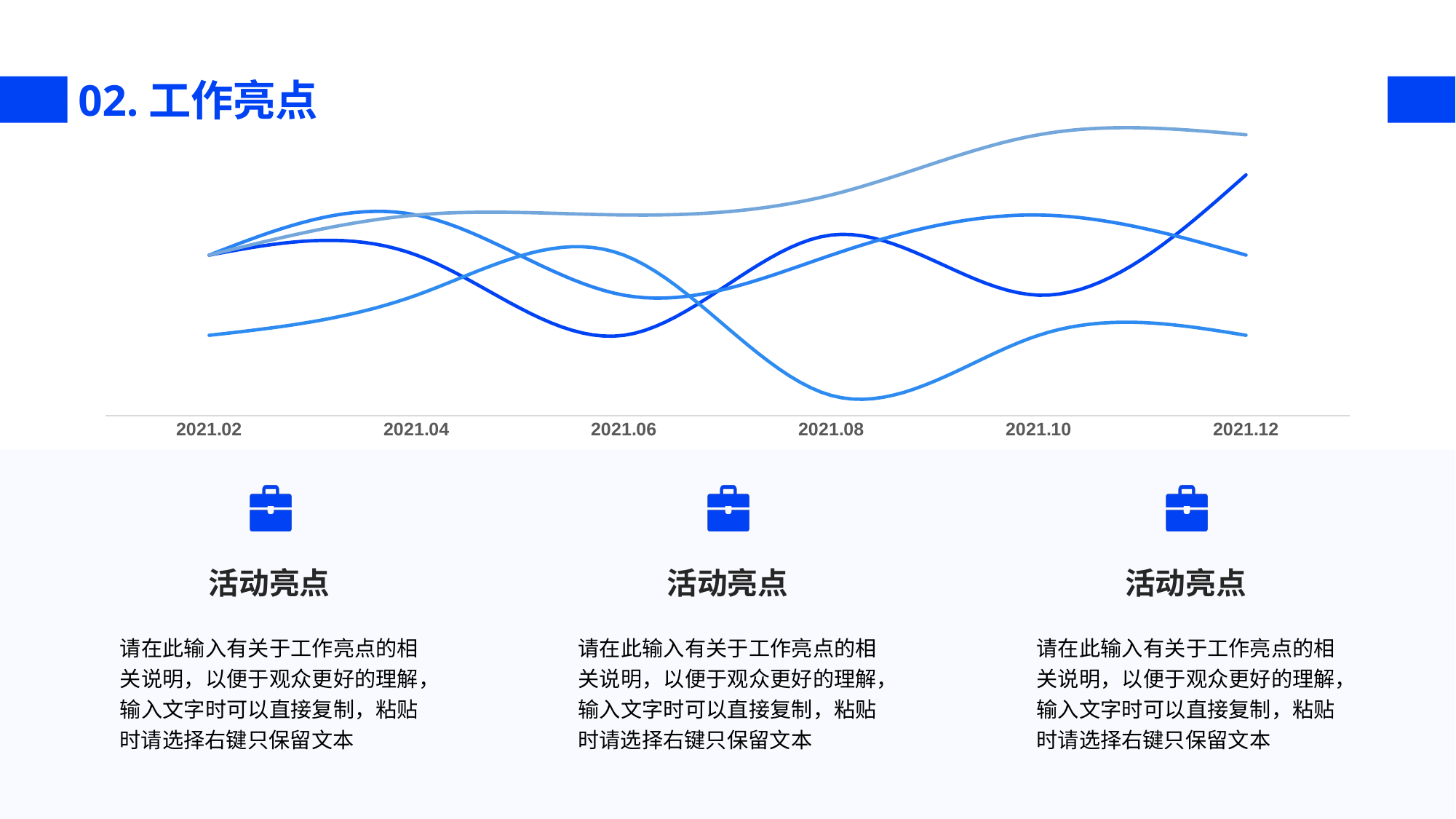
Does the lightest blue line on the chart rise or fall overall from 2021.02 to 2021.12? rise How many lines are plotted on the chart? 4 What is the last label on the x axis of the chart? 2021.12 Does the chart display a legend? No What is the first label on the x axis of the chart? 2021.02 How many points are labelled along the x axis of the chart? 6 What kind of chart is shown on the slide? line chart